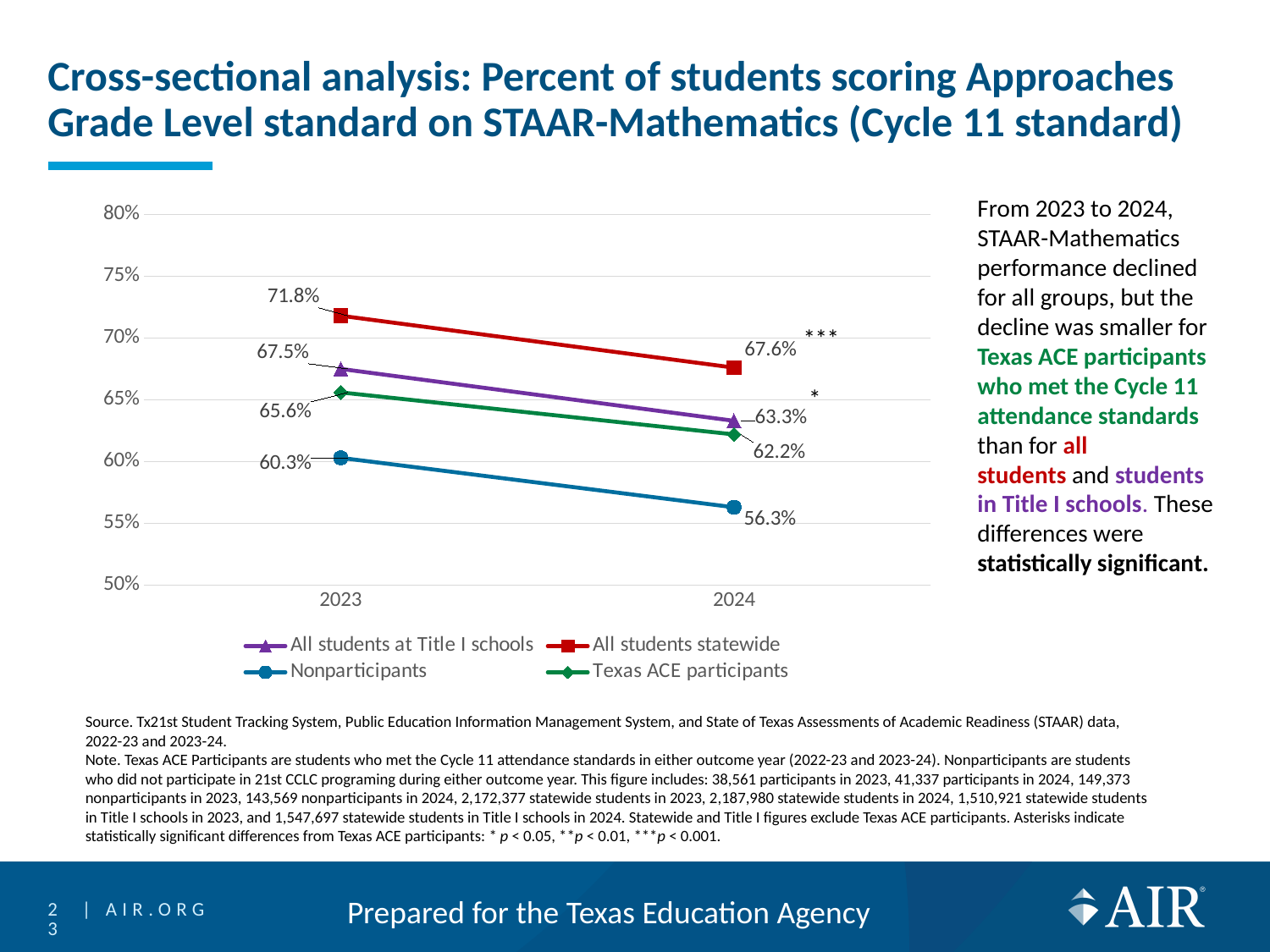
Which series had the lowest value in 2023? Nonparticipants How many series does the legend list? 4 What kind of chart is shown on the slide? Line chart What was the value for Texas ACE participants in 2024? 62.2% By how many percentage points did the value for All students statewide change from 2023 to 2024? 4.2 percentage points What was the value for Nonparticipants in 2023? 60.3% Which was larger in 2023: the value for All students at Title I schools or the value for Texas ACE participants? All students at Title I schools Which series had the highest value in 2024? All students statewide What was the value for All students at Title I schools in 2024? 63.3% What was the value for All students statewide in 2023? 71.8% How many years are shown on the x axis? 2 Do the values for Nonparticipants rise or fall from 2023 to 2024? Fall